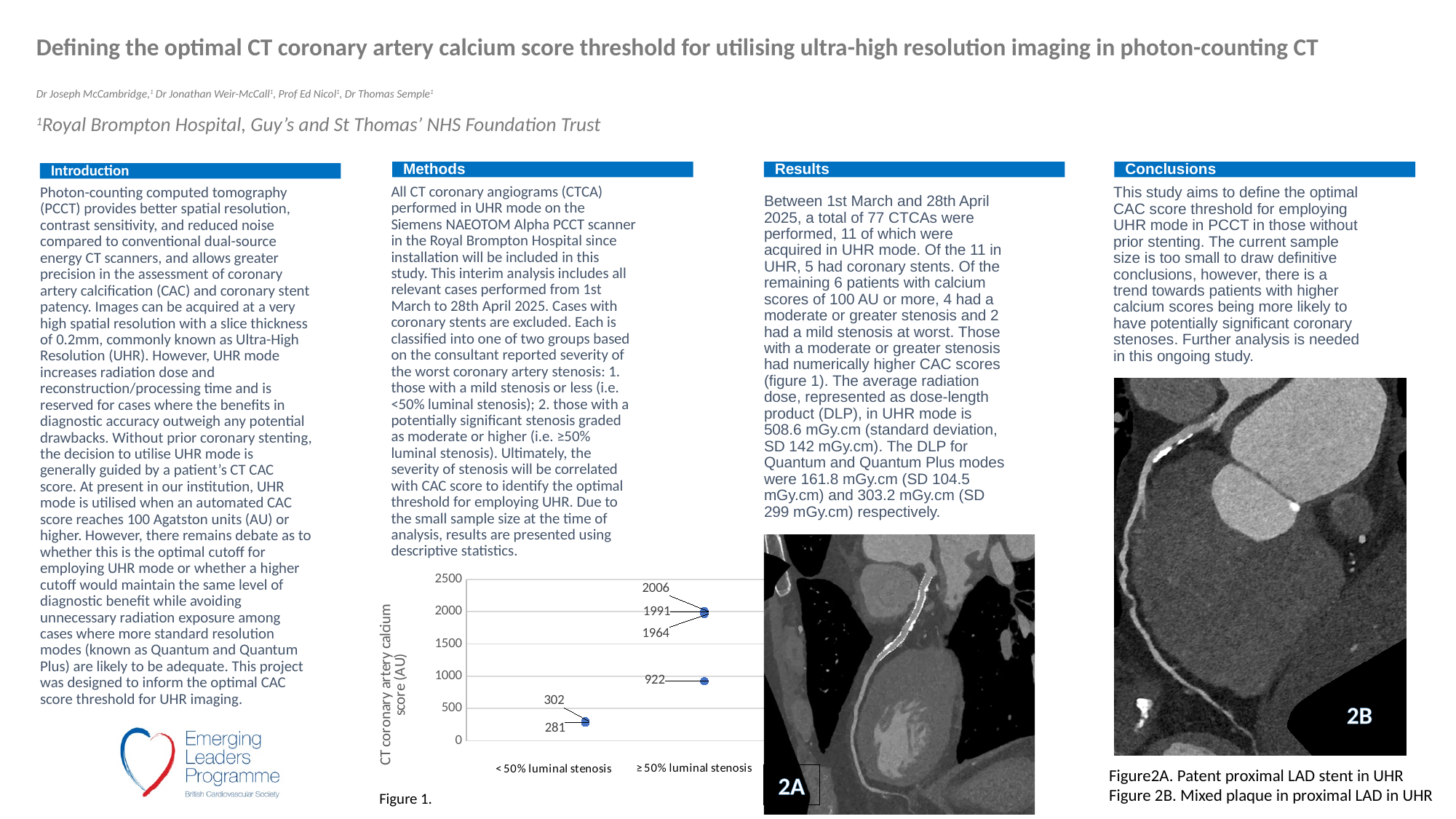
What is the maximum value shown on the y axis of the Figure 1 chart? 2500 Is the value 922 in the ≥ 50% luminal stenosis group greater or less than 1000 on the y axis of Figure 1? less What is the difference between the two labelled values in the < 50% luminal stenosis group in Figure 1? 21 How many data points are labelled in the < 50% luminal stenosis group in Figure 1? 2 How many data points are labelled in the ≥ 50% luminal stenosis group in Figure 1? 4 What is the lowest CAC score labelled in the ≥ 50% luminal stenosis group in Figure 1? 922 What is the y-axis label of the chart in Figure 1? CT coronary artery calcium score (AU) What is the highest CAC score labelled in the ≥ 50% luminal stenosis group in Figure 1? 2006 How many categories are shown on the x axis of the Figure 1 chart? 2 Which group in Figure 1 contains the highest labelled CAC score? ≥ 50% luminal stenosis What is the lowest CAC score labelled in the < 50% luminal stenosis group in Figure 1? 281 What is the difference between the highest value (2006) and the lowest value (922) in the ≥ 50% luminal stenosis group in Figure 1? 1084